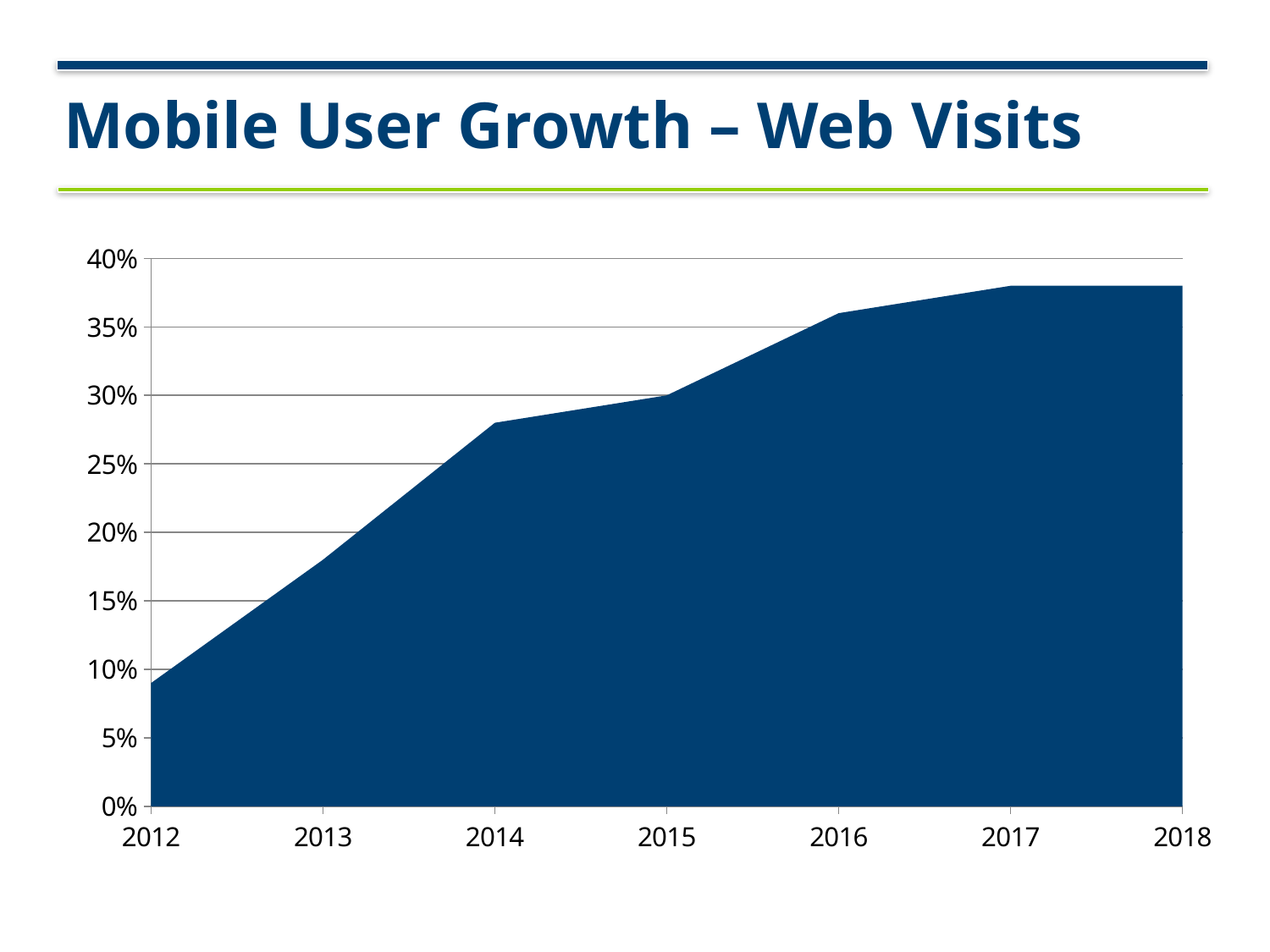
Is the value for 2013 greater or less than 15%? greater How many years are shown on the x axis? 7 Is the value for 2014 greater or less than 25%? greater Is the value for 2016 greater or less than 35%? greater Do the values generally rise or fall from 2012 to 2018? rise Which year has the larger value, 2013 or 2015? 2015 Which year has the lowest value? 2012 What kind of chart is shown on the slide? area chart Which year has the larger value, 2014 or 2016? 2016 What is the title of the slide? Mobile User Growth – Web Visits